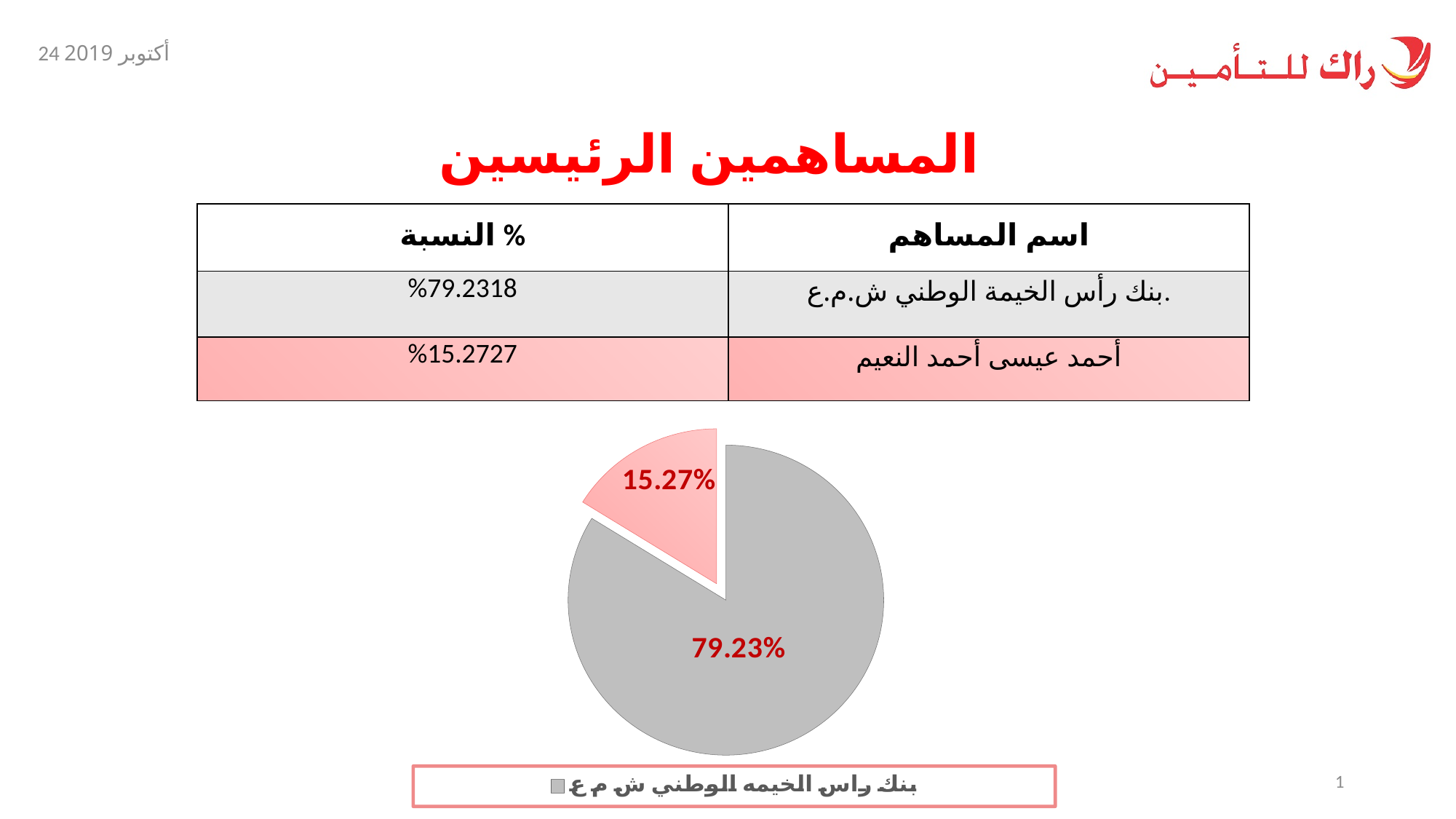
What is the value of the smallest slice in the pie chart? 15.27% Is the value of the grey slice in the pie chart greater or less than 50%? greater How many slices does the pie chart have? 2 What is the only entry shown in the pie chart's legend? بنك راس الخيمه الوطني ش م ع Which slice is larger in the pie chart, the grey one or the pink one? the grey one How many entries does the pie chart's legend list? 1 What percentage is shown on the pink slice of the pie chart? 15.27% Which slice of the pie chart is the largest? بنك راس الخيمه الوطني ش م ع (79.23%) What is the difference in percentage points between the grey slice and the pink slice of the pie chart? 63.96 What colour is the largest slice of the pie chart? grey What percentage is shown on the grey slice of the pie chart (بنك راس الخيمه الوطني ش م ع)? 79.23% What kind of chart is shown on the slide? pie chart